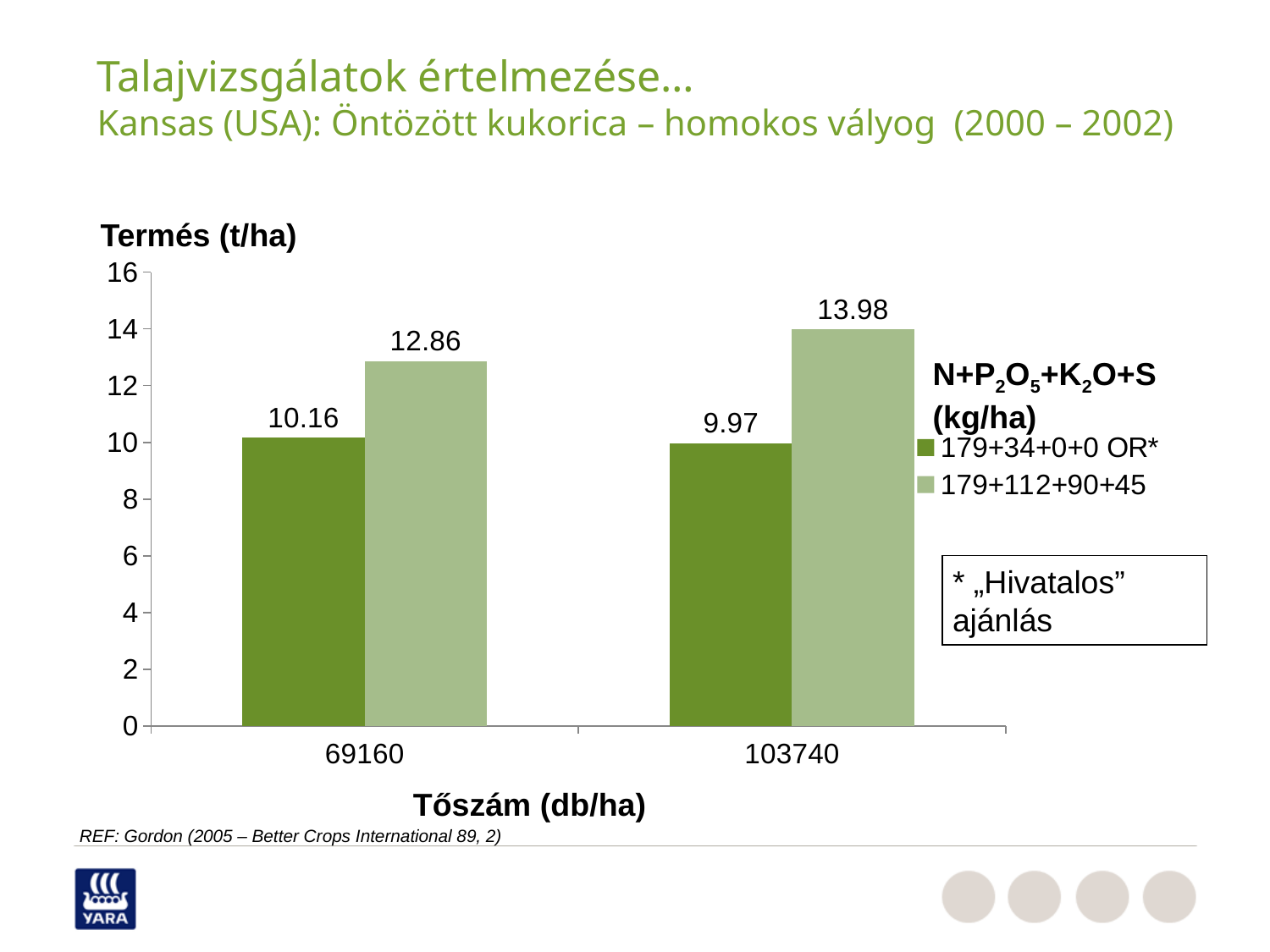
What is the yield (Termés, t/ha) for the 179+34+0+0 OR* treatment at a plant density of 103740 db/ha? 9.97 What is the difference in yield between the 179+112+90+45 and 179+34+0+0 OR* treatments at 69160 db/ha? 2.70 What is the yield (Termés, t/ha) for the 179+112+90+45 treatment at a plant density of 69160 db/ha? 12.86 What is the yield (Termés, t/ha) for the 179+112+90+45 treatment at a plant density of 103740 db/ha? 13.98 How many plant density (Tőszám) categories are shown on the x axis? 2 What type of chart is shown on the slide? Bar chart Which bar shows the lowest yield on the chart? 179+34+0+0 OR* at 103740 db/ha Which bar shows the highest yield on the chart? 179+112+90+45 at 103740 db/ha Which treatment gives the higher yield at 69160 db/ha, 179+34+0+0 OR* or 179+112+90+45? 179+112+90+45 What is the difference in yield between the 179+112+90+45 and 179+34+0+0 OR* treatments at 103740 db/ha? 4.01 How many fertiliser treatments (series) does the legend list? 2 What is the yield (Termés, t/ha) for the 179+34+0+0 OR* treatment at a plant density of 69160 db/ha? 10.16